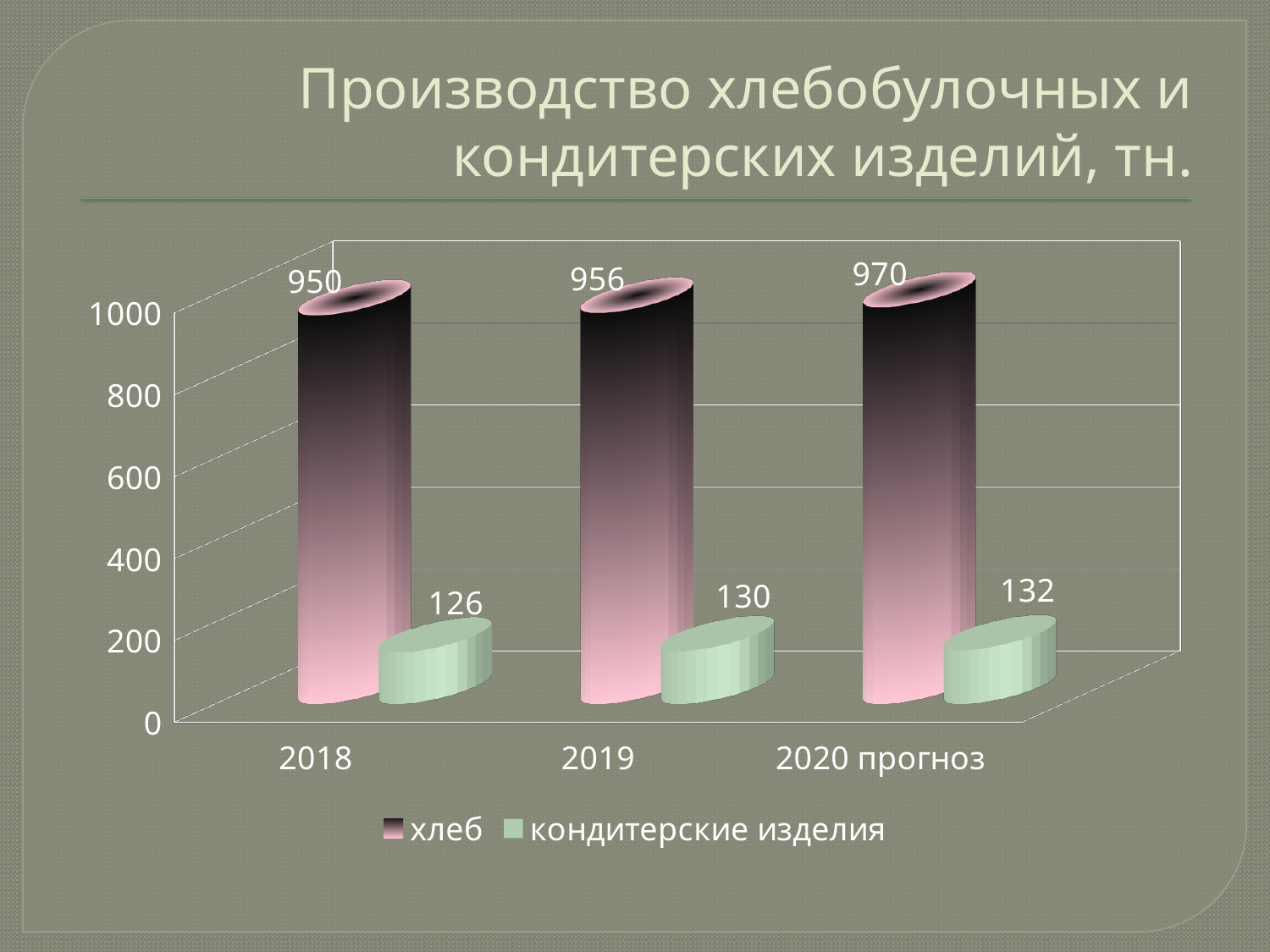
In which year is the value for хлеб highest? 2020 прогноз What is the value for кондитерские изделия in 2020 прогноз? 132 What is the value for хлеб in 2018? 950 What is the value for хлеб in 2020 прогноз? 970 What is the difference between the хлеб values for 2020 прогноз and 2018? 20 How many categories are shown on the x axis? 3 How many series does the legend list? 2 Do the values for хлеб rise or fall from 2018 to 2020 прогноз? rise In which year is the value for кондитерские изделия lowest? 2018 What kind of chart is shown on the slide? bar chart What is the value for кондитерские изделия in 2019? 130 Which is larger in 2019: хлеб or кондитерские изделия? хлеб